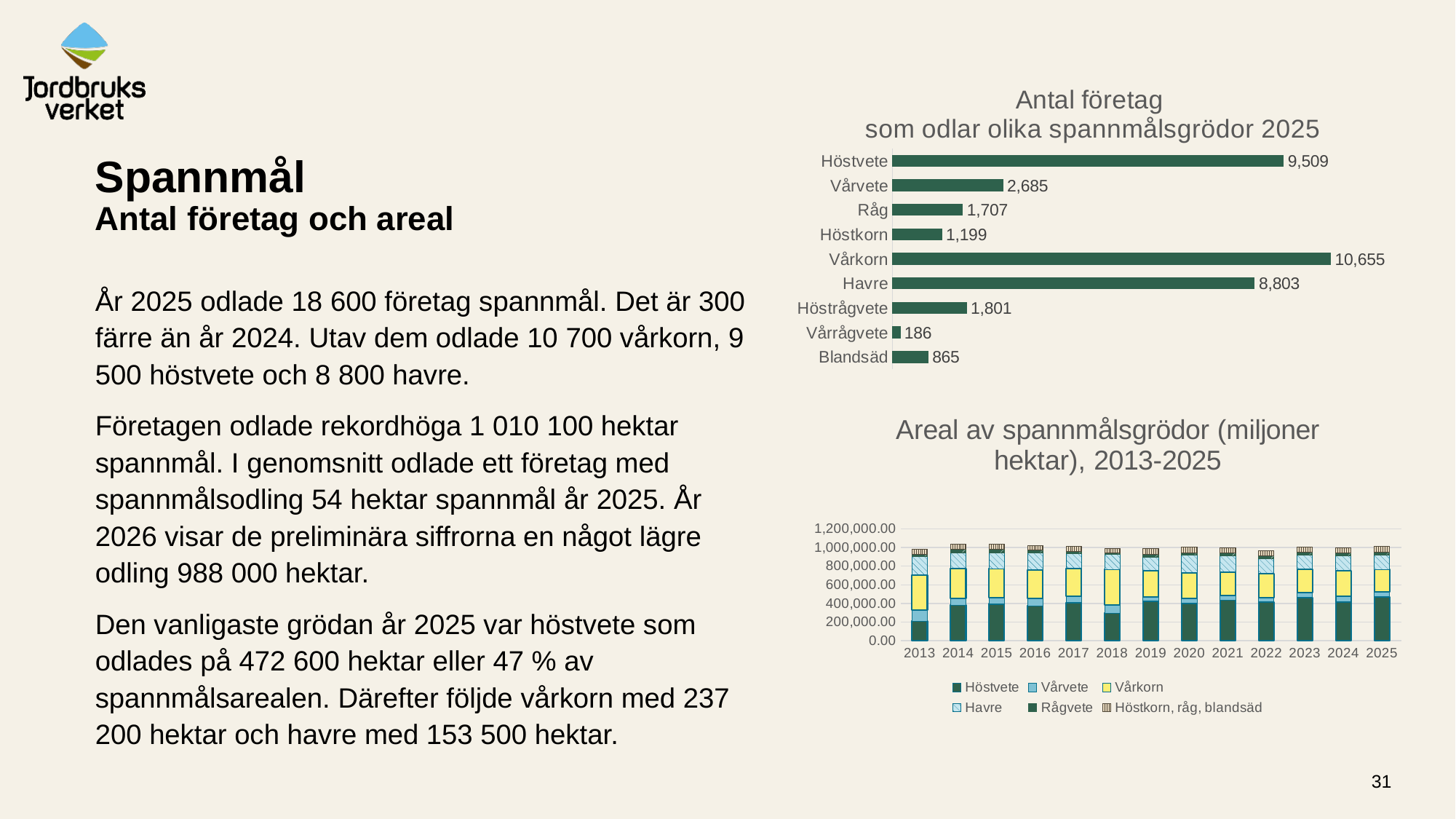
In the chart 'Antal företag som odlar olika spannmålsgrödor 2025', what is the value for Havre? 8,803 In the chart 'Antal företag som odlar olika spannmålsgrödor 2025', which is larger, the value for Råg or the value for Höstrågvete? Höstrågvete In the chart 'Antal företag som odlar olika spannmålsgrödor 2025', which crop has the highest number of companies? Vårkorn How many series does the legend list in the chart 'Areal av spannmålsgrödor (miljoner hektar), 2013-2025'? 6 In the chart 'Antal företag som odlar olika spannmålsgrödor 2025', what is the difference between the values for Vårkorn and Höstvete? 1,146 In the chart 'Antal företag som odlar olika spannmålsgrödor 2025', which crop has the lowest number of companies? Vårrågvete How many crop categories are shown in the chart 'Antal företag som odlar olika spannmålsgrödor 2025'? 9 What kind of chart is 'Antal företag som odlar olika spannmålsgrödor 2025'? Bar chart In the chart 'Areal av spannmålsgrödor (miljoner hektar), 2013-2025', which series is listed first in the legend? Höstvete How many years are shown on the x axis of the chart 'Areal av spannmålsgrödor (miljoner hektar), 2013-2025'? 13 In the chart 'Antal företag som odlar olika spannmålsgrödor 2025', how many companies grow Höstvete? 9,509